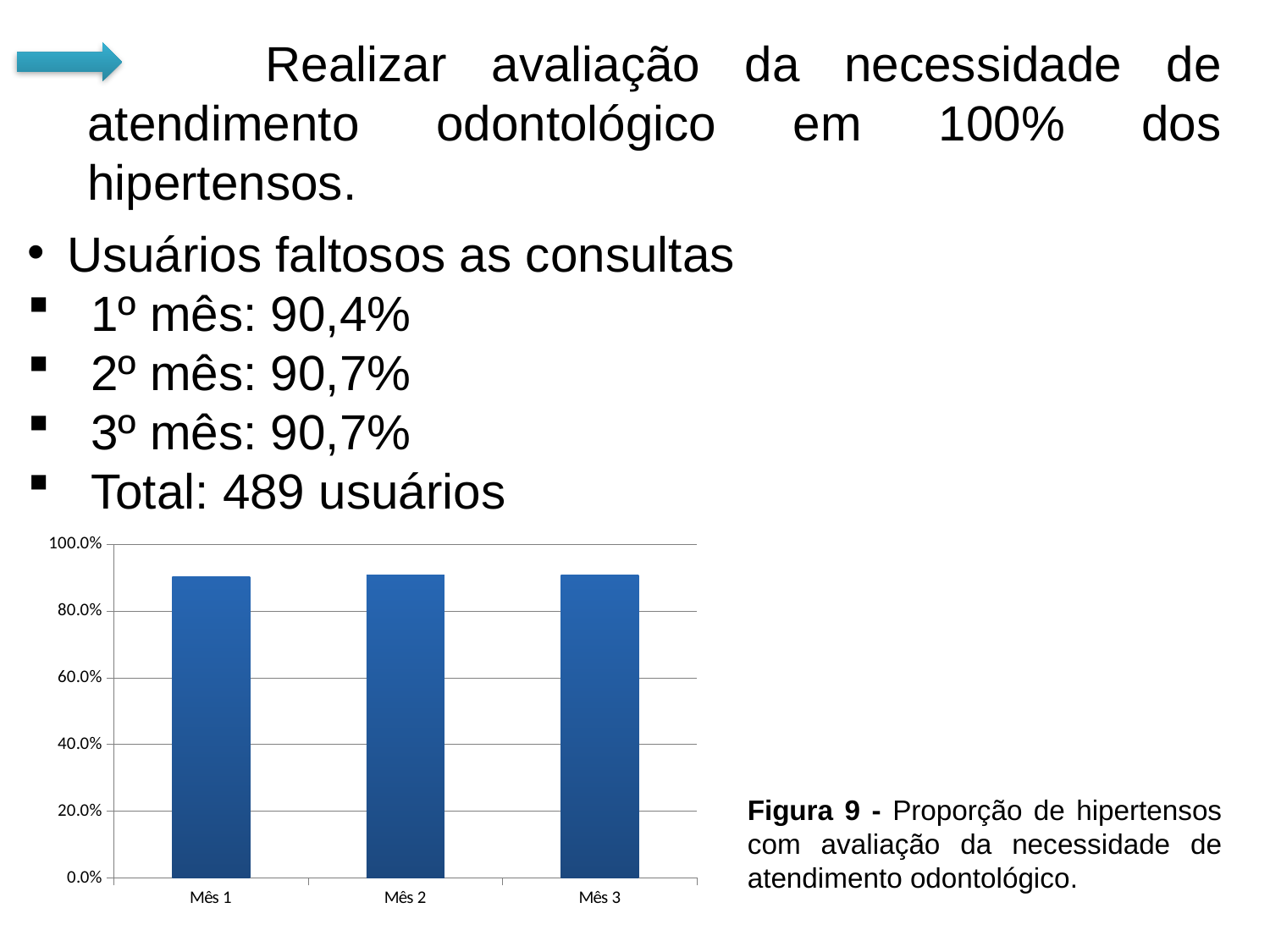
How many categories (months) are plotted on the x axis of the chart? 3 What kind of chart is shown on the slide? bar chart What colour are the bars in the chart? blue Is the value for Mês 2 greater or less than 40.0%? greater Is the value for Mês 3 greater or less than 60.0%? greater Is the value for Mês 2 greater or less than 100.0%? less What is the figure caption given for the chart? Figura 9 - Proporção de hipertensos com avaliação da necessidade de atendimento odontológico. Across Mês 1, Mês 2 and Mês 3, do the bars rise sharply, fall sharply, or stay roughly level? stay roughly level